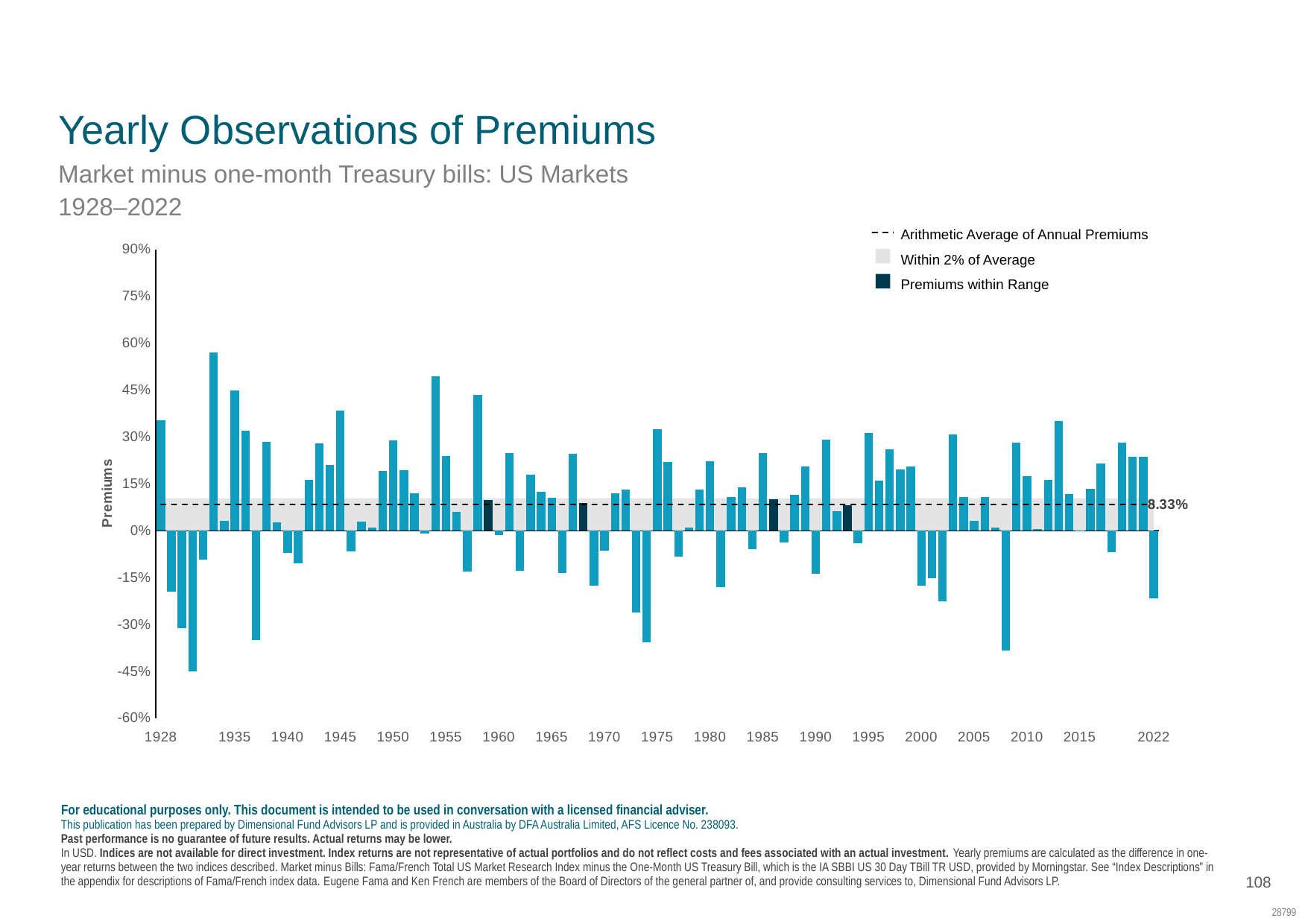
How many entries does the legend list? 3 Which year has the larger premium, 1933 or 1954? 1933 What value is printed for the arithmetic average of annual premiums? 8.33% Is the value for 1933 greater or less than 45%? greater Which year has the highest premium on the chart? 1933 What type of chart is shown on the slide? bar chart What is the label on the vertical axis? Premiums Which year has the lowest premium on the chart? 1931 How many years does the chart cover, from 1928 to 2022? 95 Is the value for 1931 greater or less than -30%? less Is the value for 1928 greater or less than 30%? greater